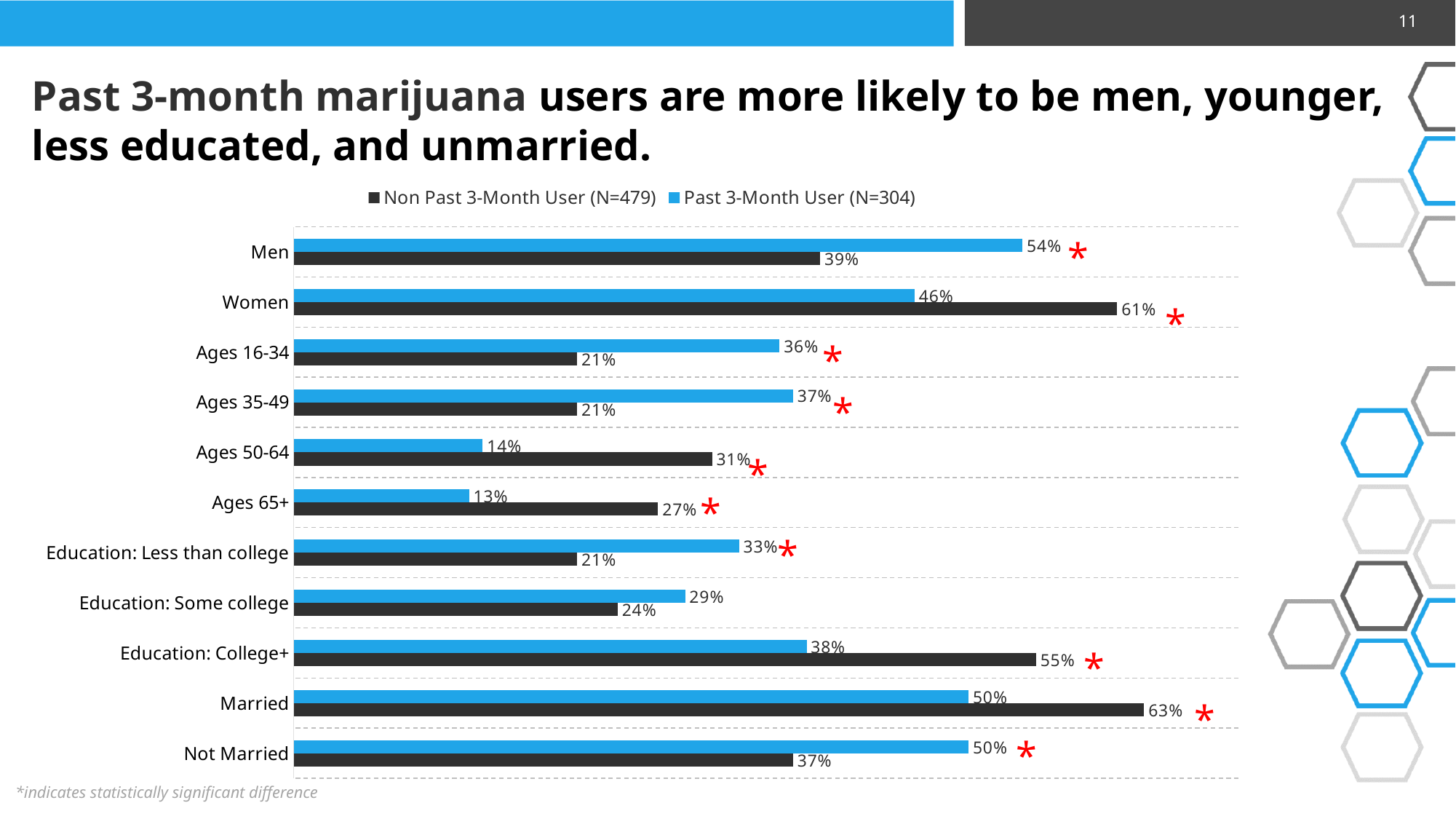
How many categories are shown on the chart? 11 How many series does the legend list? 2 What is the value for Education: College+ among Non Past 3-Month Users? 55% What is the value for Ages 65+ among Past 3-Month Users? 13% What is the difference between Past 3-Month Users and Non Past 3-Month Users for Ages 16-34? 15 percentage points Which category has the highest value for Non Past 3-Month Users? Married For Ages 50-64, which series has the larger value: Past 3-Month User or Non Past 3-Month User? Non Past 3-Month User What percentage of Past 3-Month Users are men? 54% Which category has the lowest value for Past 3-Month Users? Ages 65+ What kind of chart is shown on the slide? Bar chart What colour represents the Past 3-Month User series? Blue What percentage of Non Past 3-Month Users are women? 61%